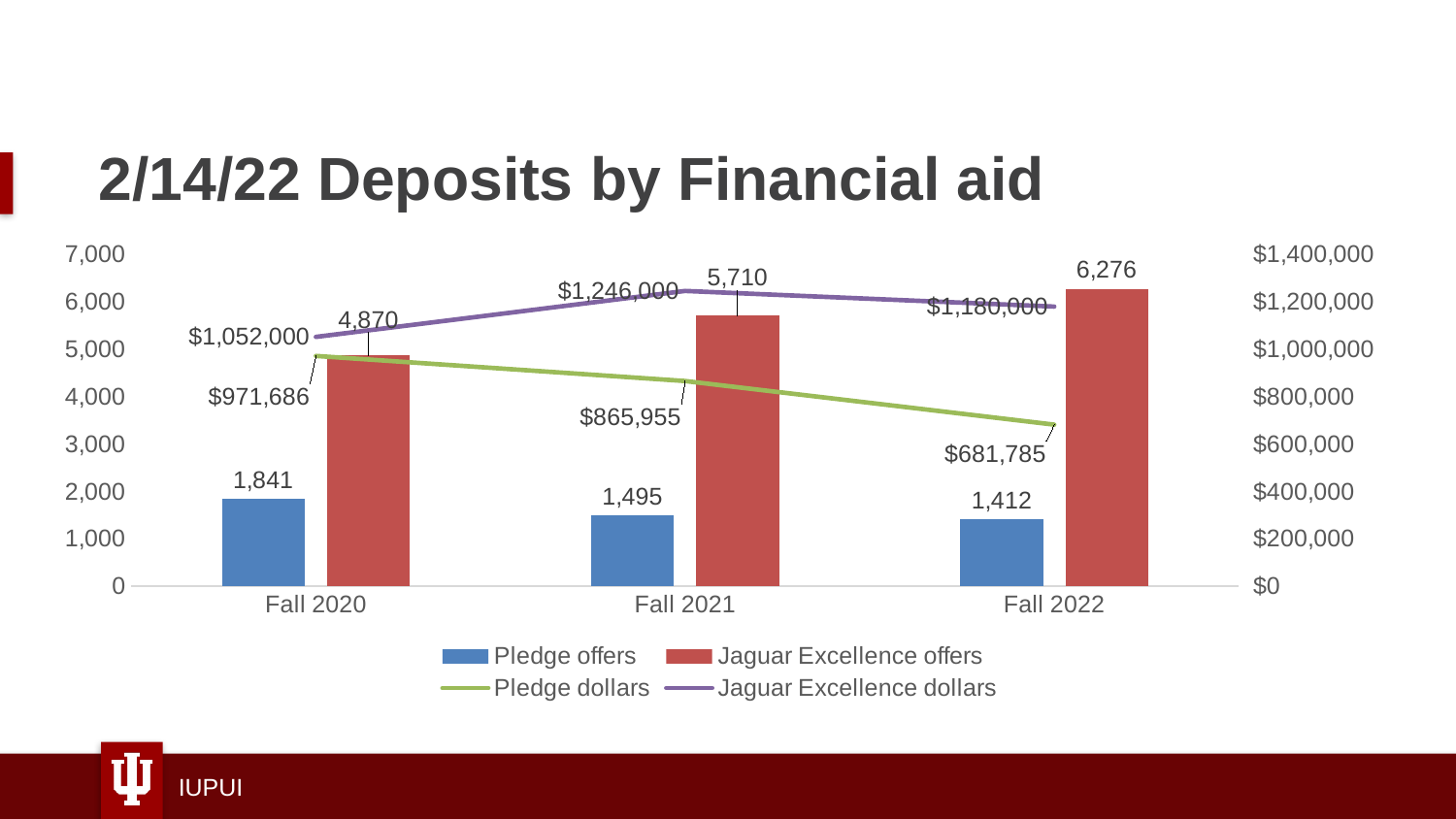
What is the value of Jaguar Excellence offers for Fall 2022? 6,276 How many series does the legend list? 4 How many terms are shown on the x axis? 3 Which is larger in Fall 2020: Jaguar Excellence dollars or Pledge dollars? Jaguar Excellence dollars What is the value of Pledge offers for Fall 2020? 1,841 What is the title of the chart? 2/14/22 Deposits by Financial aid In which term are Pledge dollars lowest? Fall 2022 What is the value of Pledge dollars for Fall 2021? $865,955 What is the difference between Jaguar Excellence offers and Pledge offers in Fall 2021? 4,215 Do Pledge offers rise or fall from Fall 2020 to Fall 2022? fall What is the value of Jaguar Excellence dollars for Fall 2021? $1,246,000 In which term are Jaguar Excellence offers highest? Fall 2022